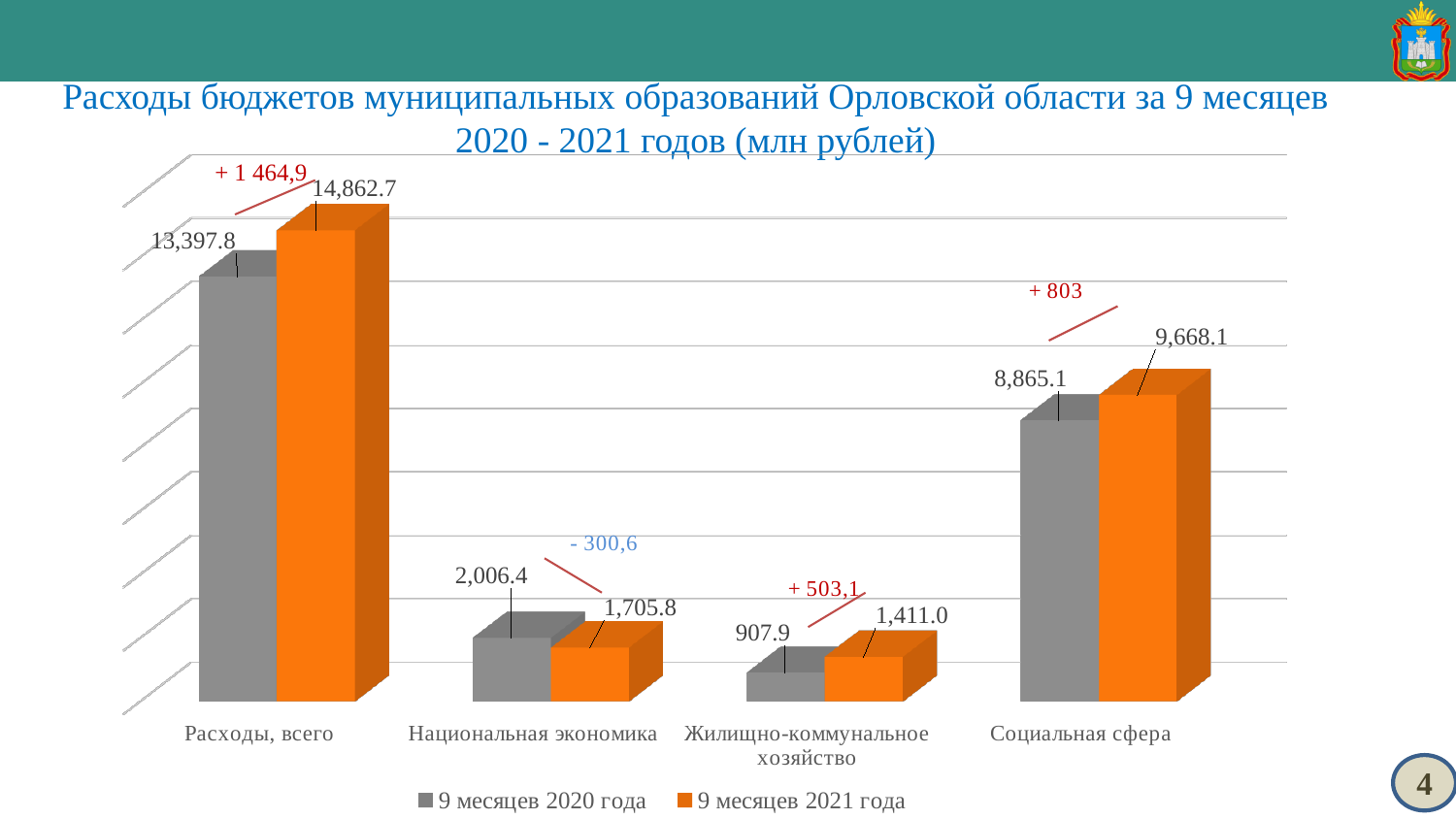
How many series does the legend list? 2 What is the difference between the 9 месяцев 2021 года and 9 месяцев 2020 года values for Жилищно-коммунальное хозяйство? 503.1 What is the value for Расходы, всего in the 9 месяцев 2020 года series? 13,397.8 For Национальная экономика, which series has the larger value: 9 месяцев 2020 года or 9 месяцев 2021 года? 9 месяцев 2020 года What is the value for Жилищно-коммунальное хозяйство in the 9 месяцев 2020 года series? 907.9 What is the difference between the 9 месяцев 2020 года and 9 месяцев 2021 года values for Национальная экономика? 300.6 Excluding Расходы, всего, which category has the lowest value in the 9 месяцев 2020 года series? Жилищно-коммунальное хозяйство Which category has the highest value in the 9 месяцев 2021 года series? Расходы, всего What is the value for Социальная сфера in the 9 месяцев 2021 года series? 9,668.1 How many categories are shown on the x axis? 4 What is the value for Национальная экономика in the 9 месяцев 2021 года series? 1,705.8 What is the value for Расходы, всего in the 9 месяцев 2021 года series? 14,862.7